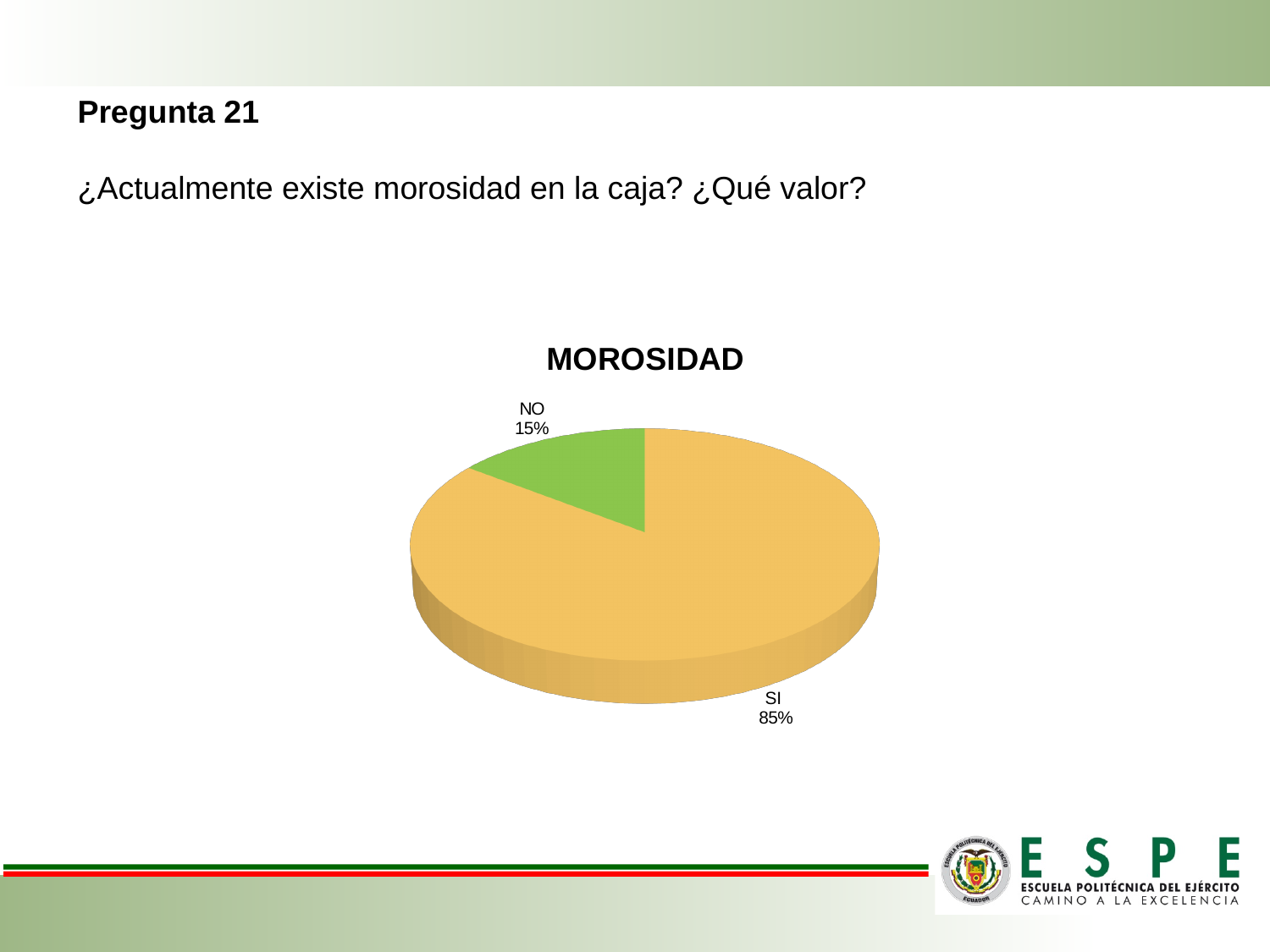
Which slice is the smallest? NO Which is larger, SI or NO? SI Which slice is the largest? SI What is the difference in percentage points between SI and NO? 70 What kind of chart is shown on the slide? pie chart How many slices does the pie chart have? 2 What is the title of the chart? MOROSIDAD What percentage is shown for SI? 85% What percentage is shown for NO? 15% What share of the pie does the NO slice represent? 15% What colour is the SI slice? orange